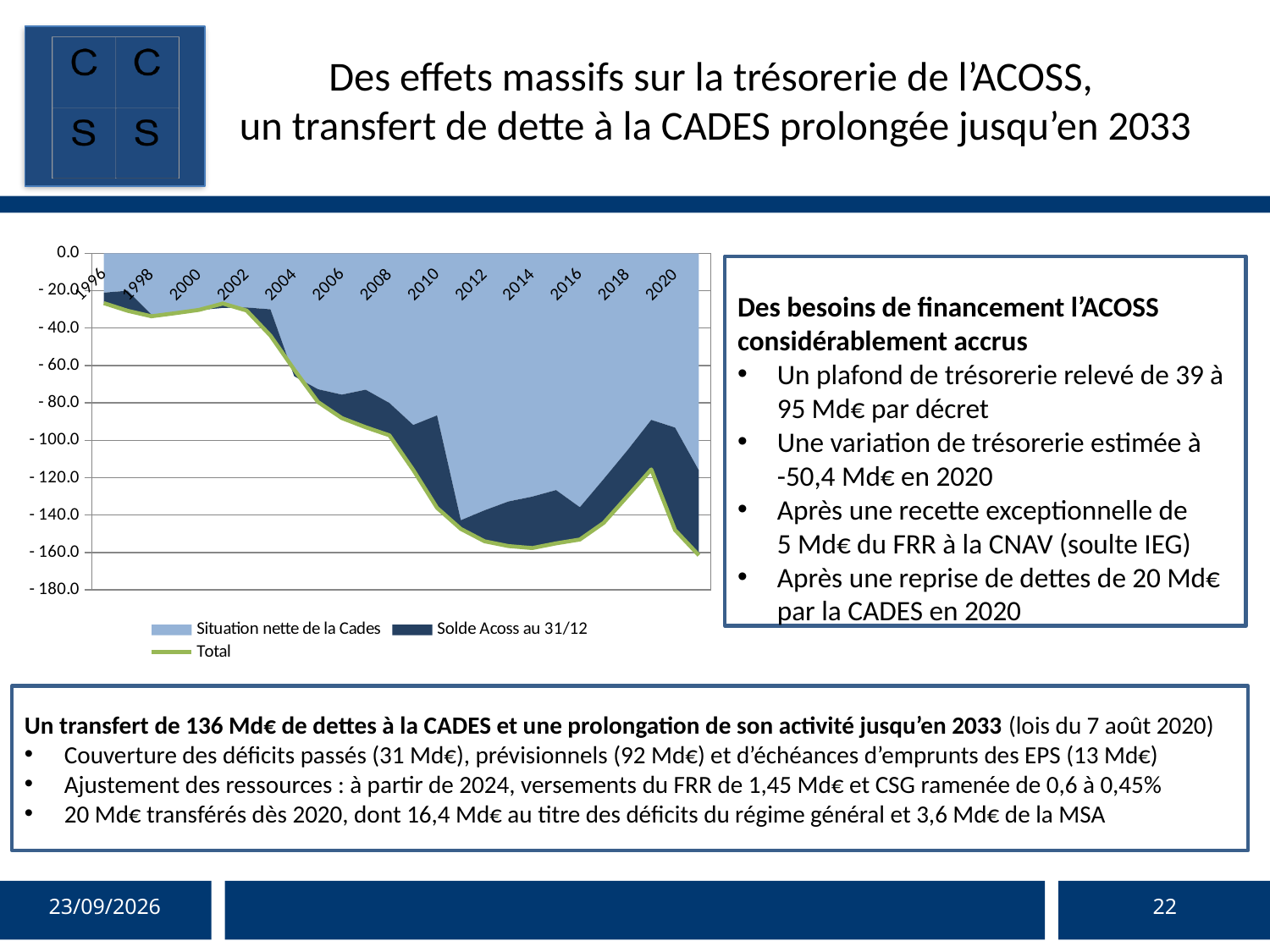
Is the Total value for 1996 greater or less than -40? greater Which is larger, the Total value for 2010 or the Total value for 2018? 2018 Is the Total value for 2020 greater or less than -140? less What kind of chart is shown on the slide? combination area and line chart What is the lowest value shown on the y axis of the chart? -180.0 How many series does the chart legend list? 3 How many year labels appear on the x axis of the chart? 13 Which series is drawn as a green line in the chart? Total What are the three entries in the chart legend? Situation nette de la Cades, Solde Acoss au 31/12, Total What is the first year labelled on the x axis of the chart? 1996 What is the last year labelled on the x axis of the chart? 2020 Does the Total line rise or fall between 1996 and 2014? fall